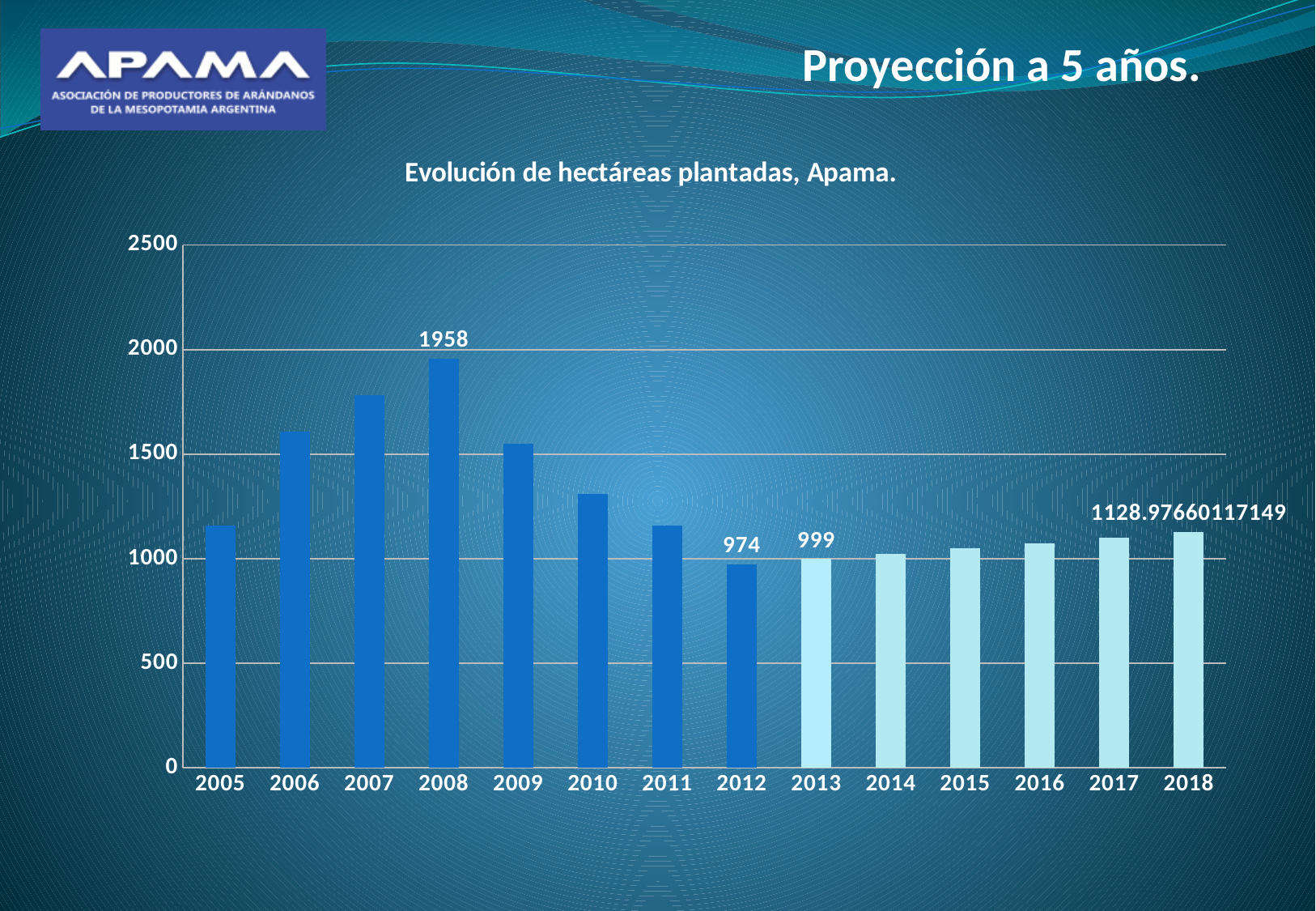
How many years are shown on the x axis of the chart? 14 Which year has the lowest value in the chart? 2012 What is the value shown for 2013? 999 What type of chart is shown on the slide? bar chart Which year has the highest value in the chart? 2008 What is the value shown for 2018? 1128.97660117149 Do the values rise or fall from 2013 to 2018? rise Is the value for 2007 greater or less than 1500? greater What is the value shown for 2012? 974 What is the difference between the values for 2008 and 2012? 984 What is the title of the chart? Evolución de hectáreas plantadas, Apama. What is the value shown for 2008? 1958